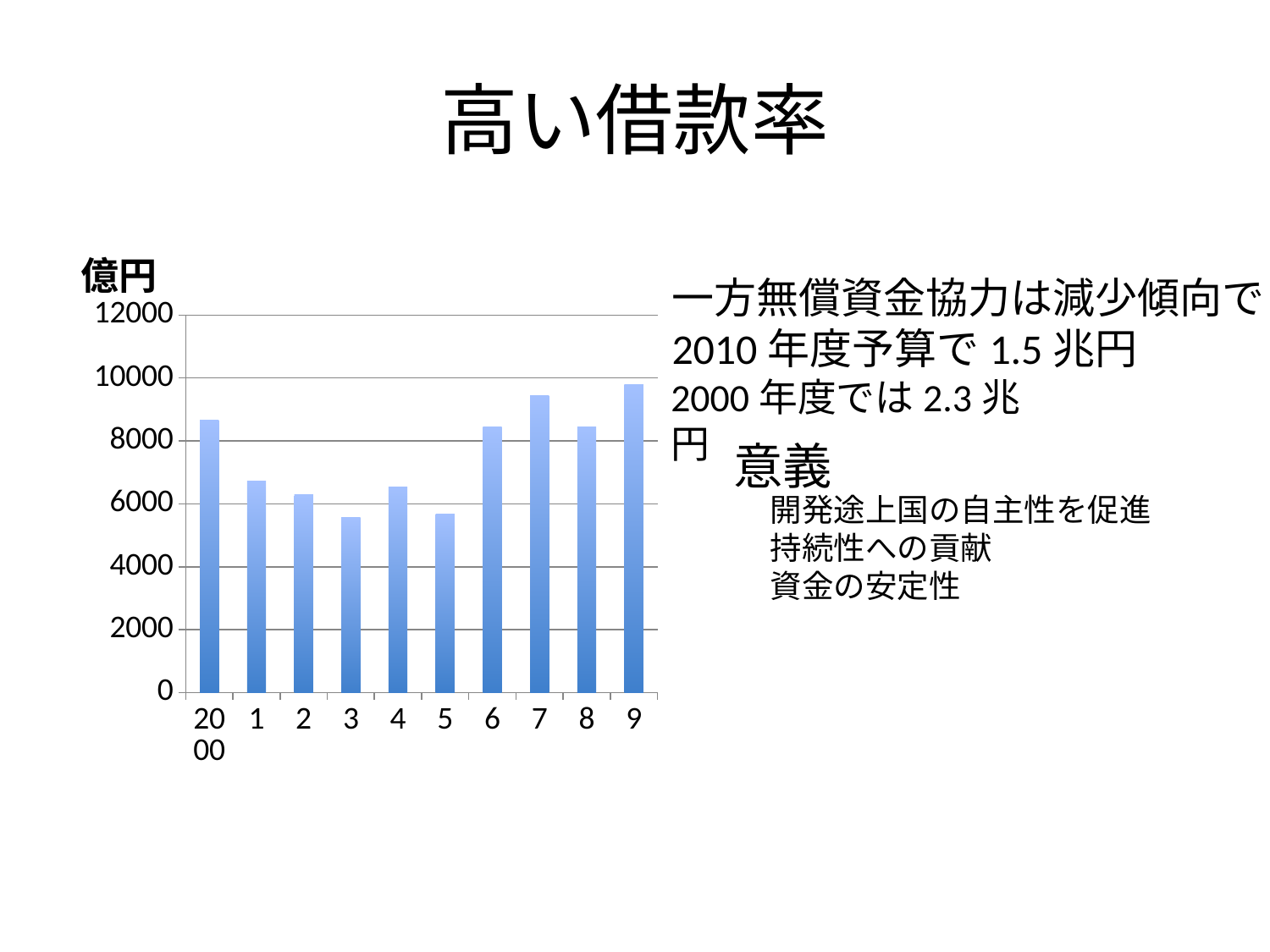
Is the value for year 3 greater or less than 6000? less Which is larger, the value for year 7 or the value for year 6? 7 Is the value for year 9 greater or less than 10000? less Do the values rise or fall from 2000 to year 3? fall Which year has the tallest bar in the chart? 9 Is the value for 2000 greater or less than 8000? greater Which is larger, the value for 2000 or the value for year 1? 2000 How many bars (years) are plotted in the chart? 10 What kind of chart is shown on the slide? bar chart What unit is shown above the vertical axis of the chart? 億円